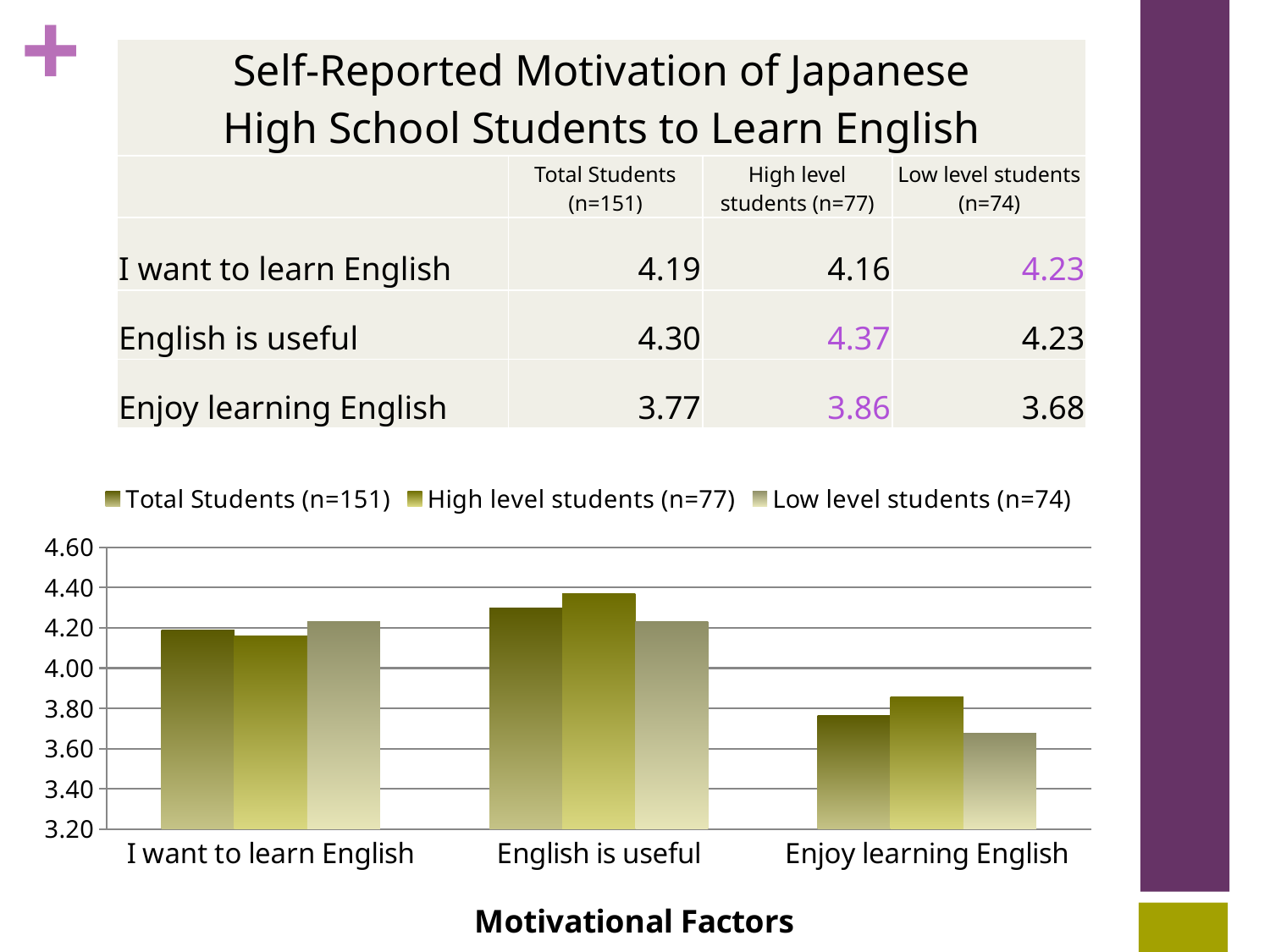
What is the difference between High level students (n=77) and Low level students (n=74) for "Enjoy learning English"? 0.18 What is the x-axis title of the chart? Motivational Factors Is the value for Total Students (n=151) for "Enjoy learning English" greater or less than 4.00? less Which category has the lowest value for Low level students (n=74)? Enjoy learning English For "English is useful", which is larger: the value for High level students (n=77) or Low level students (n=74)? High level students (n=77) What is the value for Low level students (n=74) for "I want to learn English"? 4.23 Which category has the highest value for High level students (n=77)? English is useful How many categories are shown on the x axis of the chart? 3 What kind of chart is shown on the slide? bar chart What is the value for Total Students (n=151) for "English is useful"? 4.30 What is the value for High level students (n=77) for "Enjoy learning English"? 3.86 How many series does the chart legend list? 3